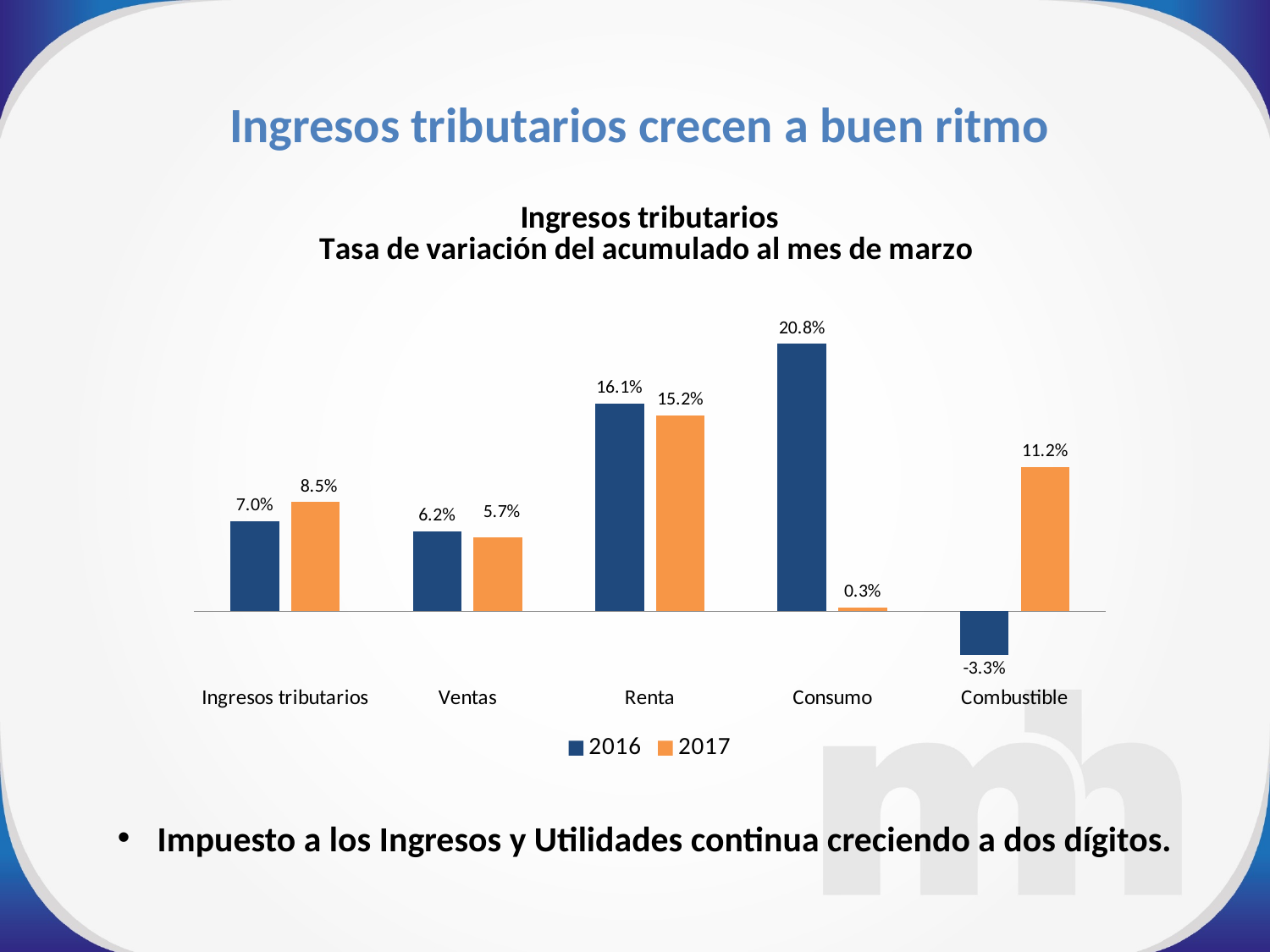
What is the 2017 value for Consumo? 0.3% What is the 2017 value for Renta? 15.2% How many categories are shown on the x axis? 5 What kind of chart is shown on the slide? Bar chart Which category has the highest 2016 value? Consumo What is the 2016 value for Combustible? -3.3% What is the difference between the 2016 and 2017 values for Consumo? 20.5% Which is larger for Ventas, the 2016 value or the 2017 value? 2016 What is the difference between the 2016 and 2017 values for Ingresos tributarios? 1.5% How many series does the legend list? 2 Which category has the lowest 2017 value? Consumo Which series is shown in orange in the legend? 2017